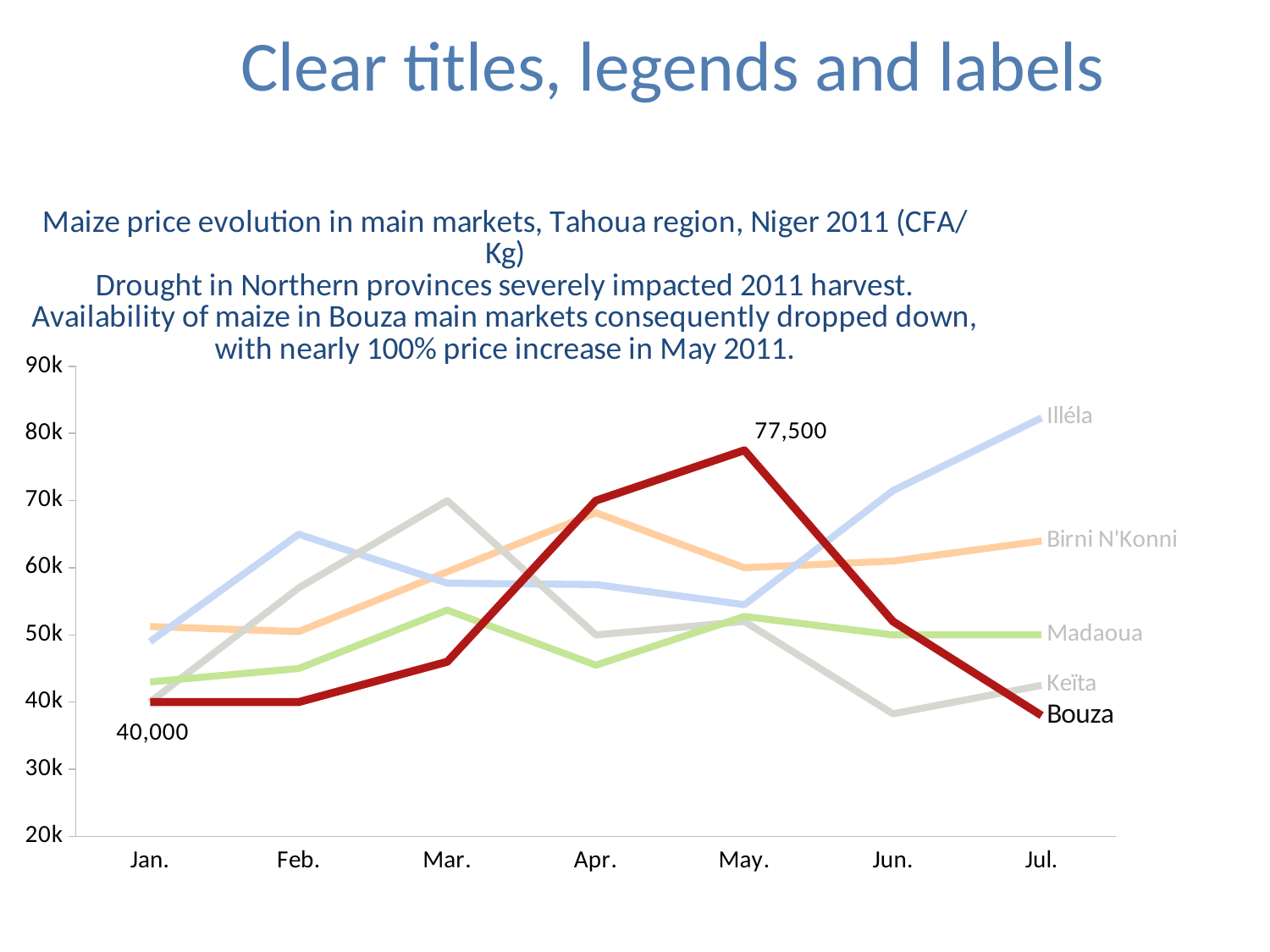
Does the Bouza line rise or fall from May to July? fall In which month does the Bouza line reach its highest value? May. Is the value for Illéla in July greater or less than 80k? greater In July, which is higher: Illéla or Bouza? Illéla Which market series is drawn with the thick dark red line? Bouza Is the value for Keïta in June greater or less than 40k? less What is the maize price for Bouza in May? 77,500 What kind of chart is shown on the slide? line chart What is the difference between the Bouza price in May and the Bouza price in January? 37,500 How many market series are labelled on the chart? 5 How many months are shown along the x axis of the chart? 7 What is the maize price for Bouza in January? 40,000